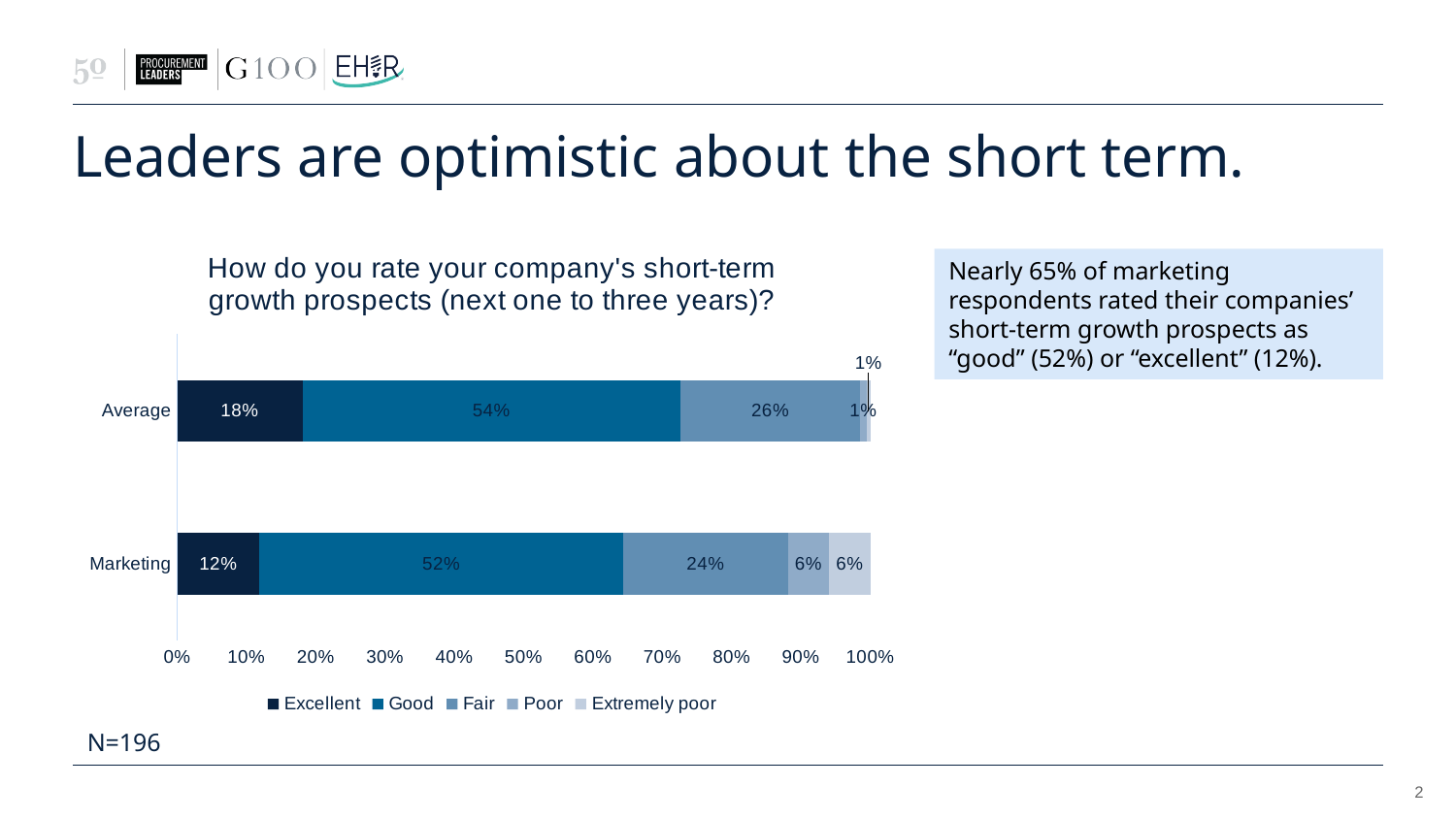
What is the 'Fair' value for Average? 26% Which category has the larger 'Excellent' value, Average or Marketing? Average What is the 'Fair' value for Marketing? 24% What is the title of the chart? How do you rate your company's short-term growth prospects (next one to three years)? What is the 'Good' value for Marketing? 52% Which series has the highest value for Marketing? Good What is the 'Excellent' value for Average? 18% What kind of chart is shown on the slide? Stacked bar chart How many categories are shown on the vertical axis? 2 What is the 'Poor' value for Marketing? 6% What is the difference between the 'Good' values for Average and Marketing? 2% How many series does the legend list? 5